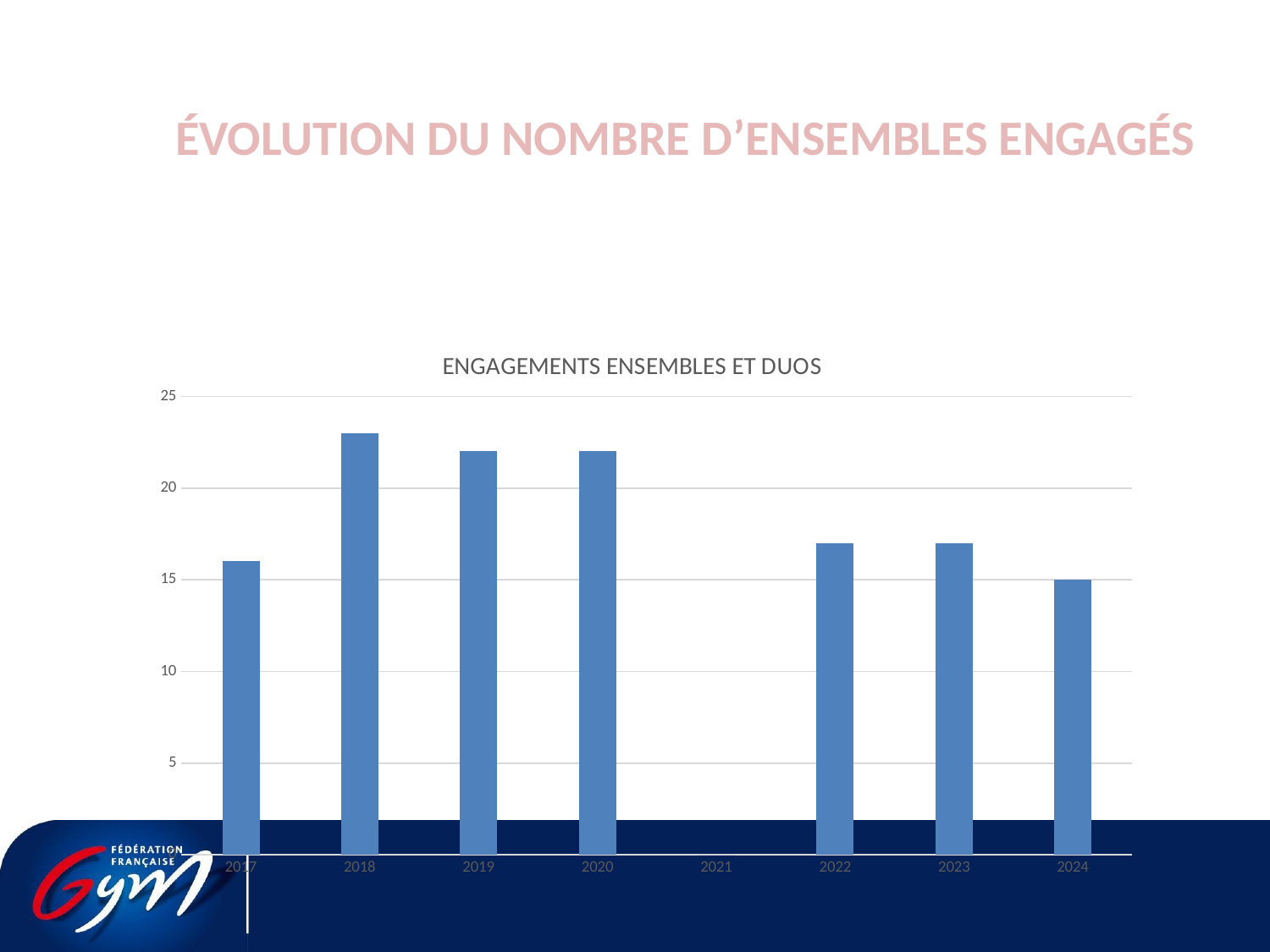
Is the value for 2017 greater or less than 20? less Which is larger, the value for 2017 or the value for 2018? 2018 Is the value for 2022 greater or less than 20? less What is the title of the chart? ENGAGEMENTS ENSEMBLES ET DUOS Is the value for 2019 greater or less than 20? greater What is the value for 2024? 15 What kind of chart is shown on the slide? bar chart Which is larger, the value for 2019 or the value for 2022? 2019 How many years are labelled on the x axis of the chart? 8 Which year has the highest bar in the chart? 2018 Do the values rise or fall from 2022 to 2024? fall